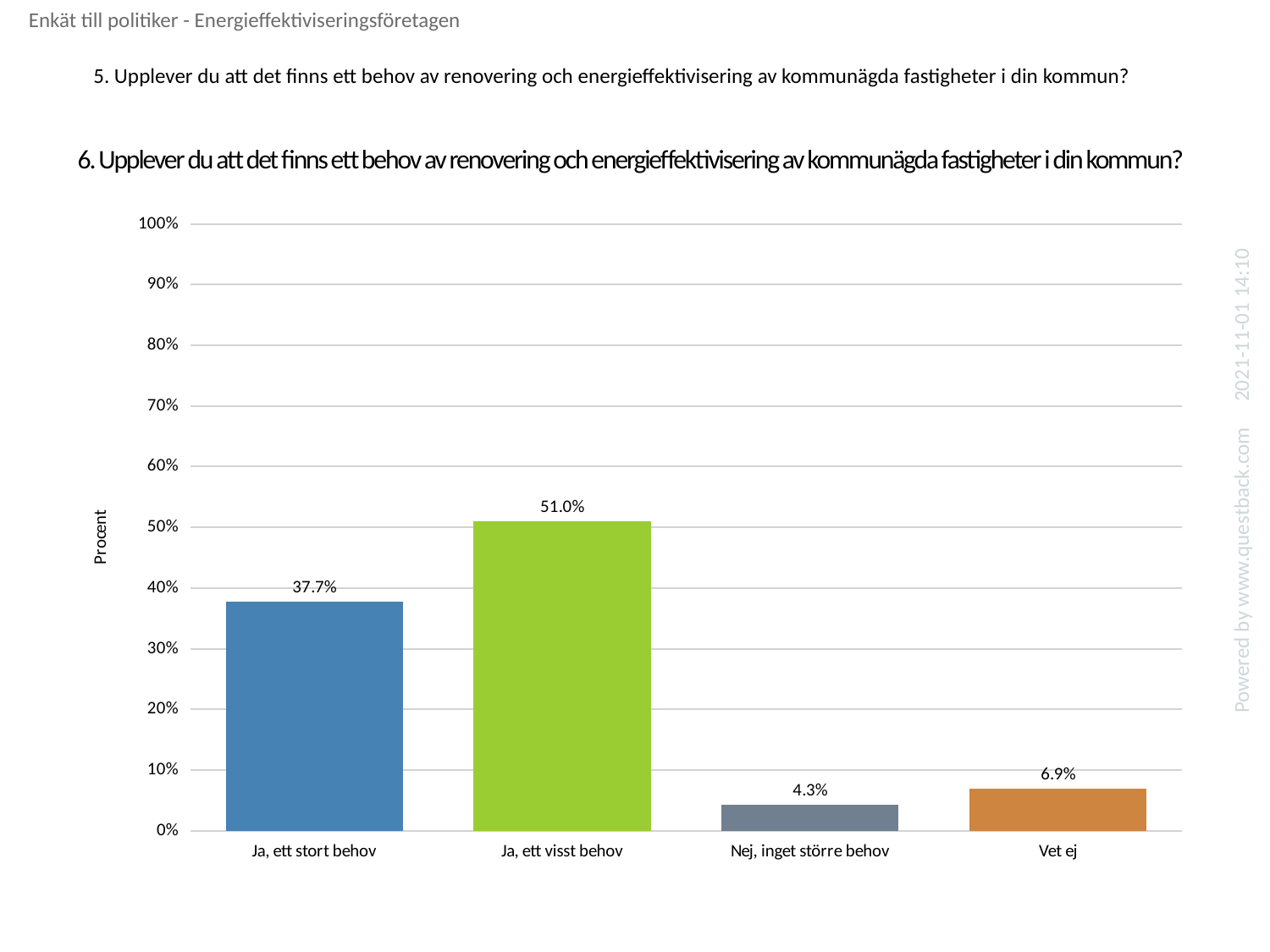
Which category has the highest value? Ja, ett visst behov What is the value for "Ja, ett stort behov"? 37.7% Which is larger, the value for "Vet ej" or the value for "Nej, inget större behov"? Vet ej What is the difference between the values for "Ja, ett visst behov" and "Ja, ett stort behov"? 13.3% Is the value for "Ja, ett stort behov" greater or less than 40%? less What is the value for "Nej, inget större behov"? 4.3% What kind of chart is shown on the slide? bar chart What is the label of the y axis? Procent Which category has the lowest value? Nej, inget större behov What is the value for "Vet ej"? 6.9% What is the value for "Ja, ett visst behov"? 51.0% How many categories are shown on the x axis? 4